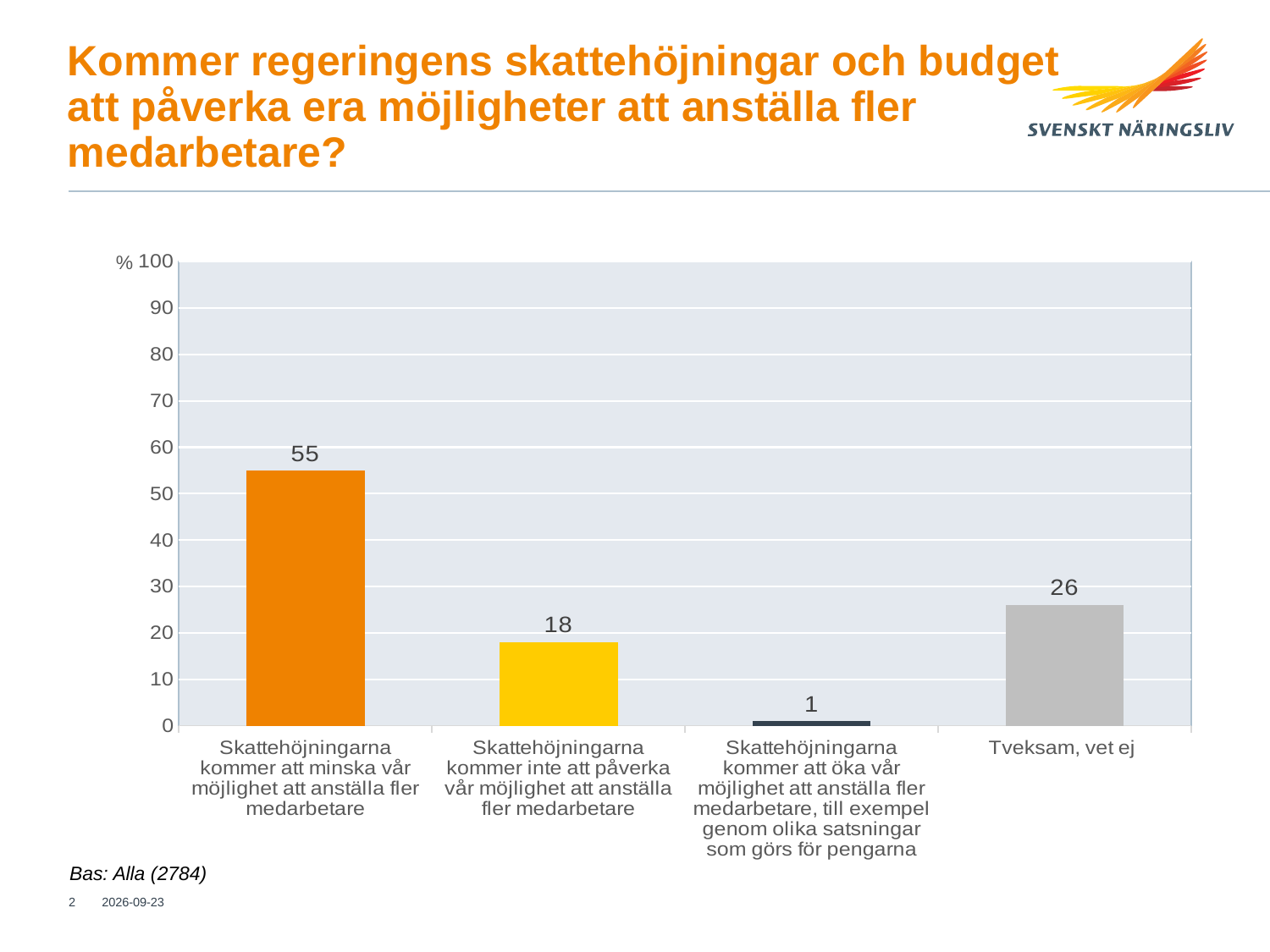
What colour is the bar for "Tveksam, vet ej"? grey What is the difference between the value for "Skattehöjningarna kommer att minska vår möjlighet att anställa fler medarbetare" and the value for "Tveksam, vet ej"? 29 What is the maximum value shown on the y axis? 100 What kind of chart is shown on the slide? bar chart Is the value for "Skattehöjningarna kommer att minska vår möjlighet att anställa fler medarbetare" greater or less than 50? greater What is the value for "Tveksam, vet ej"? 26 Which category has the lowest value? Skattehöjningarna kommer att öka vår möjlighet att anställa fler medarbetare, till exempel genom olika satsningar som görs för pengarna How many categories are shown on the x axis? 4 Which is larger: the value for "Tveksam, vet ej" or the value for "Skattehöjningarna kommer inte att påverka vår möjlighet att anställa fler medarbetare"? Tveksam, vet ej Which category has the highest value? Skattehöjningarna kommer att minska vår möjlighet att anställa fler medarbetare What is the value for "Skattehöjningarna kommer att öka vår möjlighet att anställa fler medarbetare, till exempel genom olika satsningar som görs för pengarna"? 1 What is the value for "Skattehöjningarna kommer inte att påverka vår möjlighet att anställa fler medarbetare"? 18